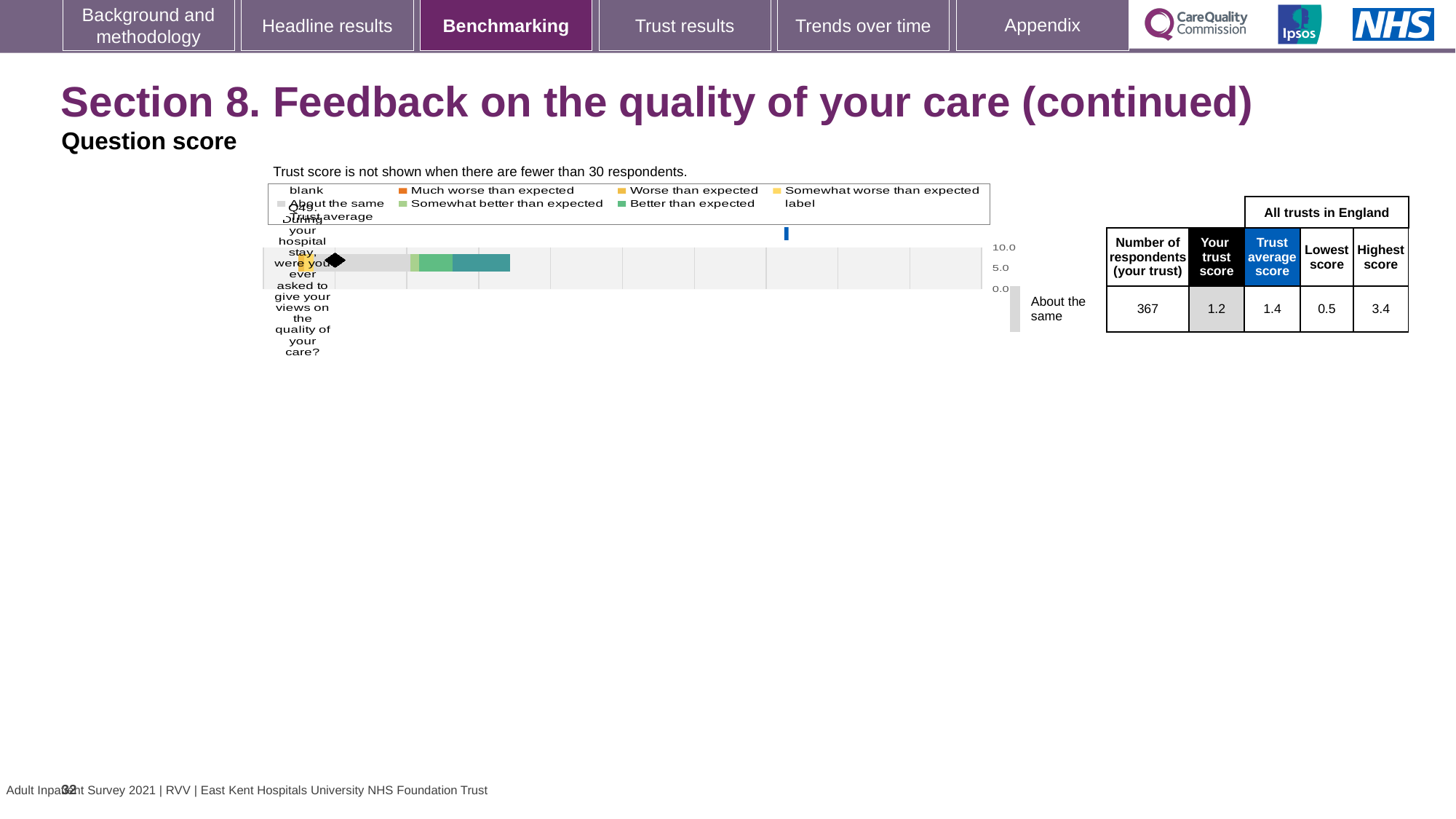
In the table beside the chart, what is the lowest score among all trusts in England? 0.5 In the table beside the chart, what is the number of respondents for your trust? 367 Which is larger for Q49: your trust score or the trust average score? trust average score How many questions (categories) are plotted in the chart? 1 What is the difference between the highest score and the lowest score for Q49 in the table? 2.9 In the table beside the chart, what is the trust average score for Q49? 1.4 What colour does the legend use for 'Much worse than expected'? orange Which question number is plotted in the chart? Q49 What kind of chart is shown on the slide? bar chart In the table beside the chart, what is the highest score among all trusts in England? 3.4 In the table beside the chart, what is your trust score for Q49? 1.2 According to the label to the right of the chart, how is the trust's score for Q49 categorised? About the same